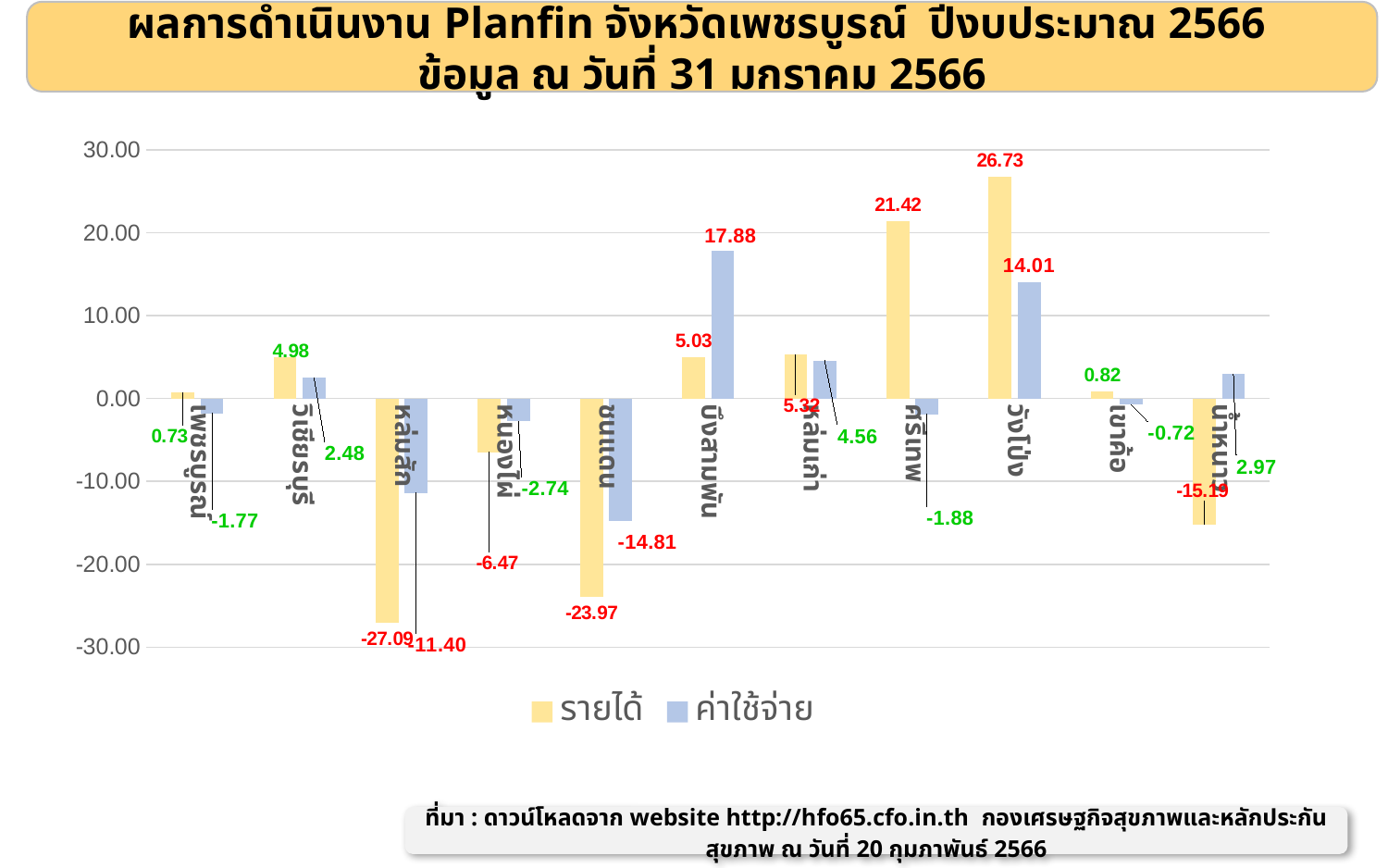
What is the รายได้ value for วังโป่ง? 26.73 What type of chart is shown on the slide? bar chart Which series is shown in yellow in the legend? รายได้ Which is larger for บึงสามพัน, the รายได้ value or the ค่าใช้จ่าย value? ค่าใช้จ่าย Which district has the lowest ค่าใช้จ่าย value? ชนแดน How many series does the legend list? 2 What is the difference between the รายได้ and ค่าใช้จ่าย values for วังโป่ง? 12.72 What is the ค่าใช้จ่าย value for บึงสามพัน? 17.88 Which district has the highest รายได้ value? วังโป่ง How many categories (districts) are shown on the x axis? 11 What is the รายได้ value for หล่มสัก? -27.09 Which district has the lowest รายได้ value? หล่มสัก